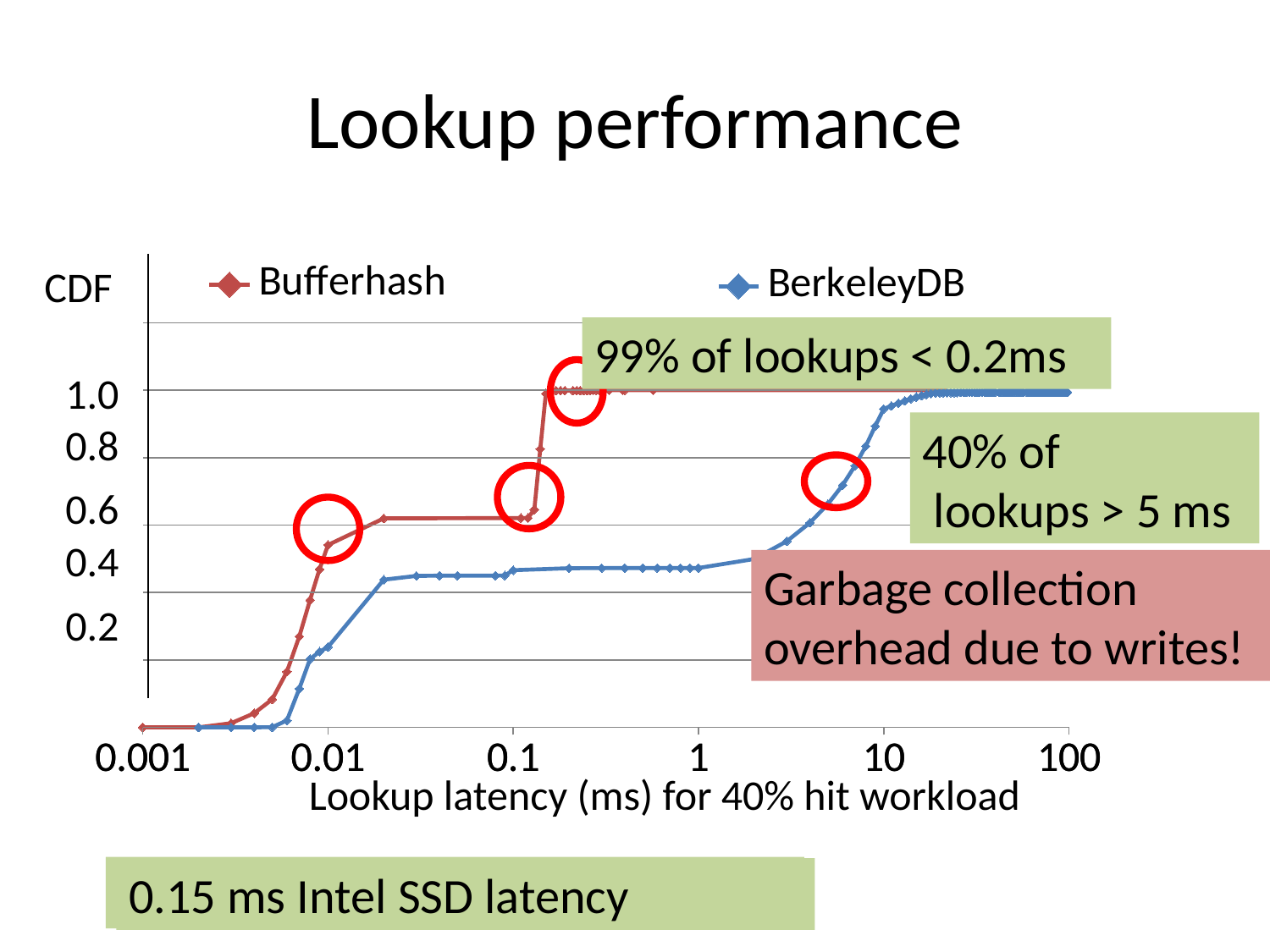
What are the two series named in the legend? Bufferhash and BerkeleyDB Is the CDF value for Bufferhash at 0.01 ms greater or less than 0.2? greater Do the CDF values for Bufferhash rise or fall as lookup latency increases along the x axis? rise What is the x-axis label of the chart? Lookup latency (ms) for 40% hit workload At a lookup latency of 1 ms, which series has the higher CDF value, Bufferhash or BerkeleyDB? Bufferhash Is the CDF value for Bufferhash at 1 ms greater or less than 0.8? greater How many series does the legend list? 2 At a lookup latency of 0.1 ms, which series has the lower CDF value, Bufferhash or BerkeleyDB? BerkeleyDB What kind of chart is shown on the slide? line chart Is the CDF value for BerkeleyDB at 0.1 ms greater or less than 0.6? less Which series reaches a CDF of 1.0 at a lower lookup latency? Bufferhash